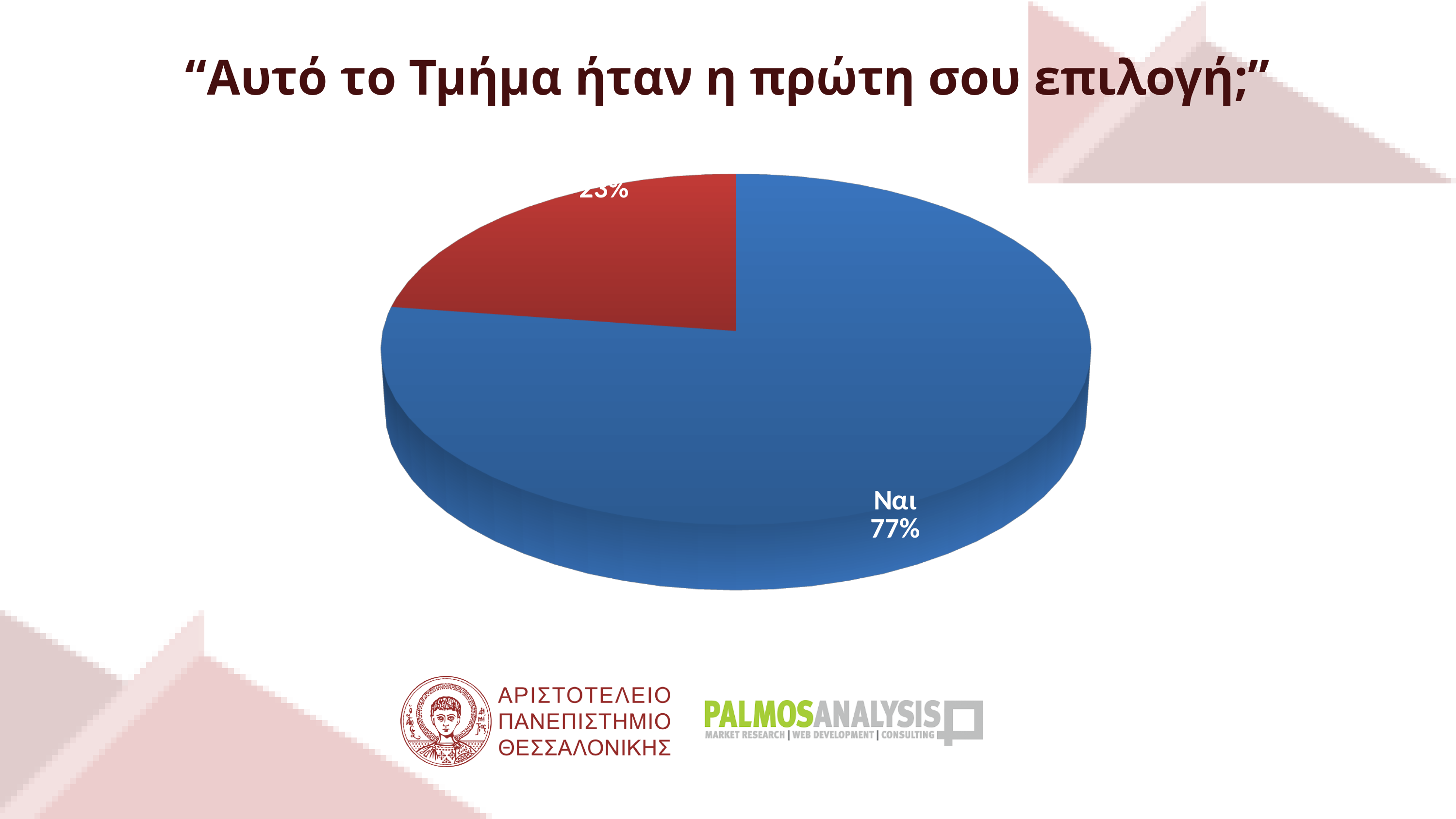
What colour is the "Ναι" slice of the pie? blue What share of the pie does the "Ναι" slice represent? 77% What kind of chart is shown on the slide? pie chart What percentage is shown on the red slice of the pie? 23% Is the share for "Ναι" greater or less than 50%? greater What is the difference in percentage points between the "Ναι" slice and the red slice? 54 Which is larger, the "Ναι" slice or the red slice? Ναι What is the title of the slide above the pie chart? "Αυτό το Τμήμα ήταν η πρώτη σου επιλογή;" How many slices does the pie chart have? 2 Which slice of the pie is the largest? Ναι What percentage of the pie is labelled "Ναι"? 77%